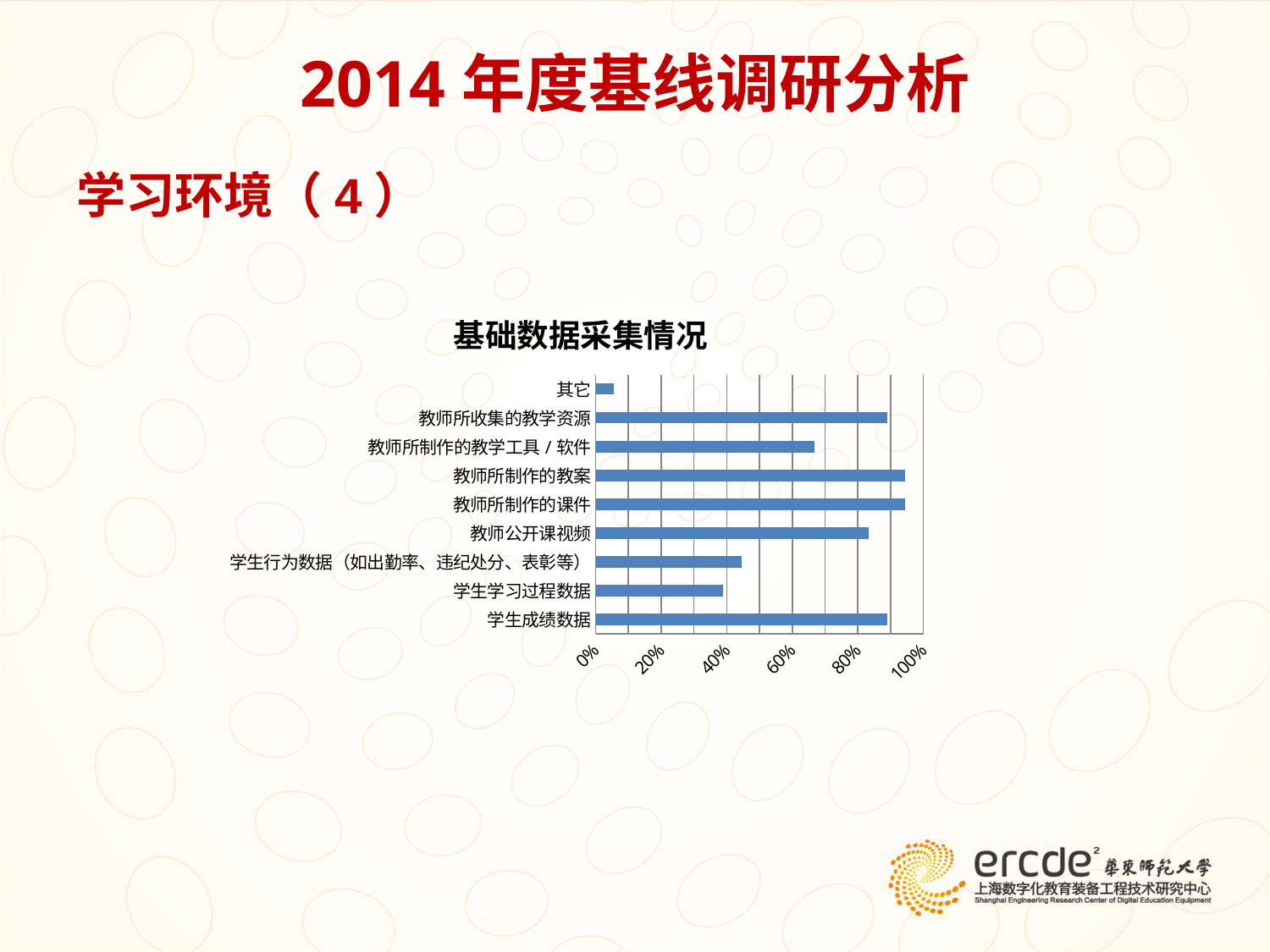
How many categories are plotted in the chart? 9 Is the value for 其它 greater or less than 20%? less What is the title of the chart? 基础数据采集情况 Which is larger, the value for 学生成绩数据 or the value for 学生学习过程数据? 学生成绩数据 Is the value for 教师所收集的教学资源 greater or less than 80%? greater What kind of chart is shown on the slide? bar chart Is the value for 学生学习过程数据 greater or less than 60%? less Which is larger, the value for 教师所制作的教学工具／软件 or the value for 学生行为数据（如出勤率、违纪处分、表彰等）? 教师所制作的教学工具／软件 Which is larger, the value for 教师所制作的课件 or the value for 教师公开课视频? 教师所制作的课件 Which category has the lowest value in the chart? 其它